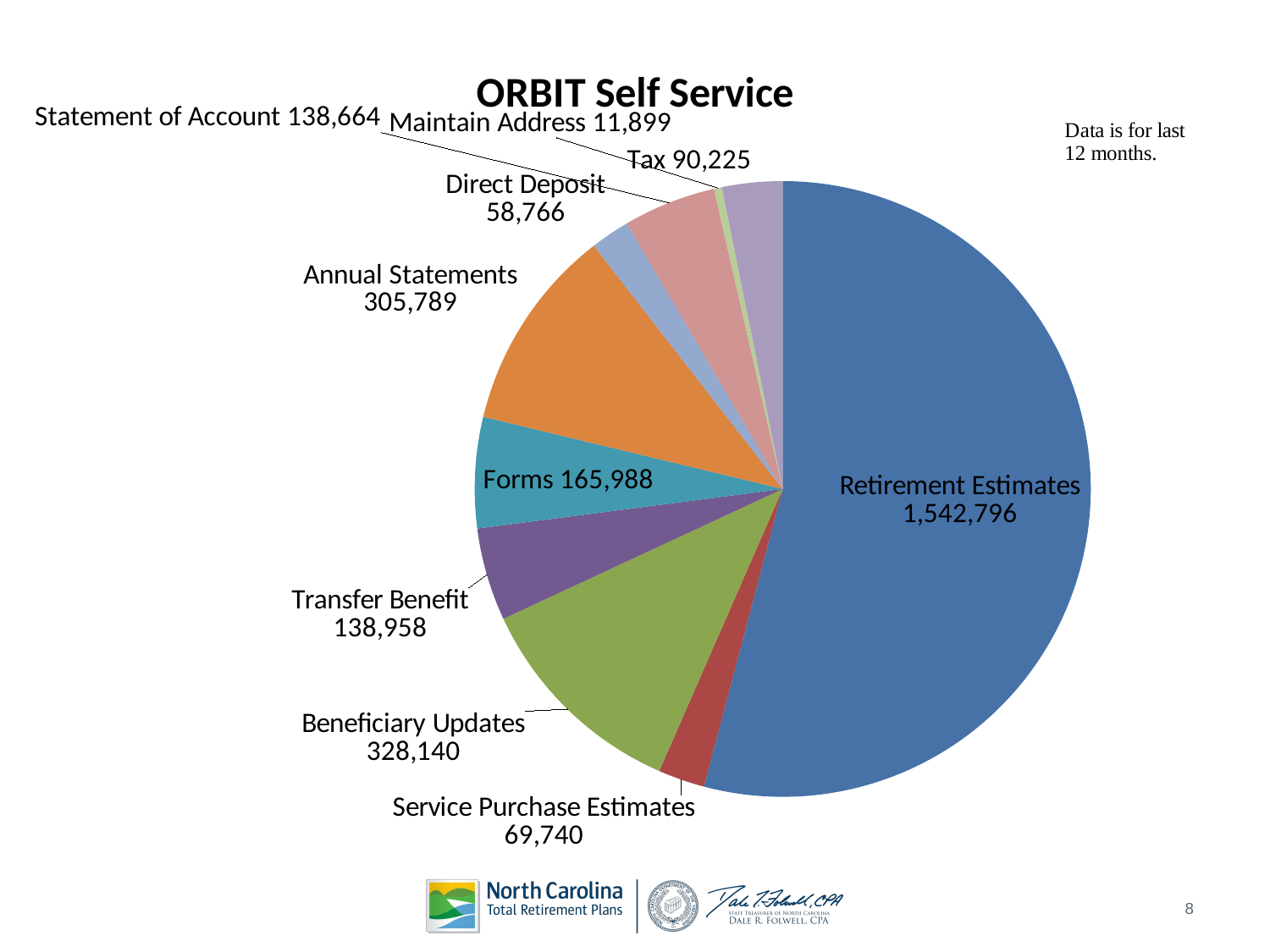
Which is larger, Annual Statements or Forms? Annual Statements What is the value for Retirement Estimates? 1,542,796 What is the difference between Beneficiary Updates and Annual Statements? 22,351 What is the value for Maintain Address? 11,899 How many slices does the pie chart have? 10 Which category has the largest slice? Retirement Estimates What is the title of the chart? ORBIT Self Service What is the value for Direct Deposit? 58,766 What is the difference between Tax and Direct Deposit? 31,459 What kind of chart is shown on the slide? Pie chart What is the value for Beneficiary Updates? 328,140 Which category has the smallest slice? Maintain Address